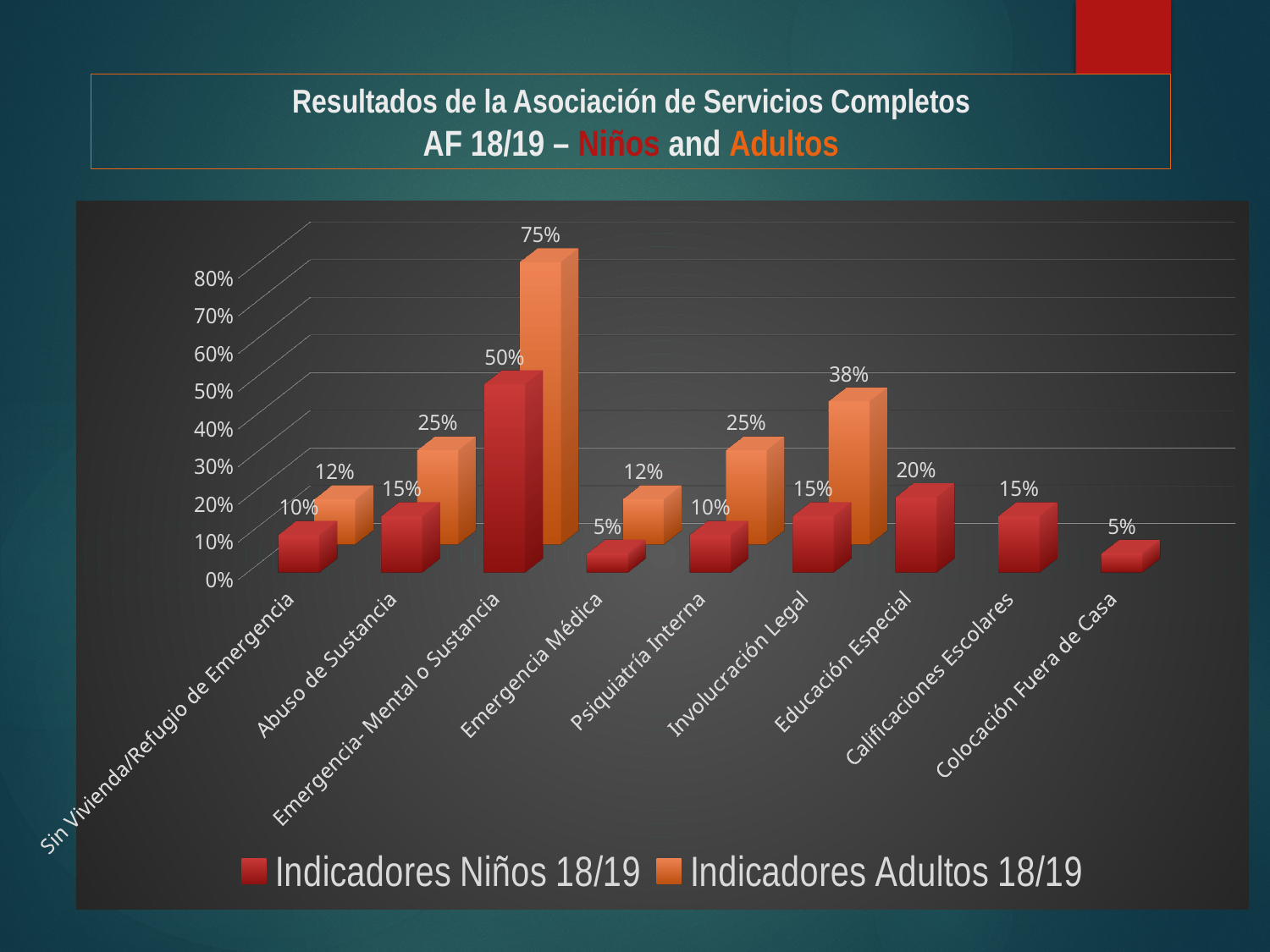
Which category has the highest value for Indicadores Adultos 18/19? Emergencia- Mental o Sustancia Which is larger for Psiquiatría Interna: Indicadores Niños 18/19 or Indicadores Adultos 18/19? Indicadores Adultos 18/19 What is the value for Indicadores Niños 18/19 for Emergencia- Mental o Sustancia? 50% How many categories are shown on the x axis? 9 What is the value for Indicadores Niños 18/19 for Educación Especial? 20% What is the value for Indicadores Adultos 18/19 for Involucración Legal? 38% Which category has the highest value for Indicadores Niños 18/19? Emergencia- Mental o Sustancia How many series does the legend list? 2 What is the difference between the Indicadores Adultos 18/19 and Indicadores Niños 18/19 values for Involucración Legal? 23% What is the difference between the Indicadores Adultos 18/19 and Indicadores Niños 18/19 values for Emergencia- Mental o Sustancia? 25% Which colour represents Indicadores Adultos 18/19 in the chart? Orange What kind of chart is shown on the slide? Bar chart